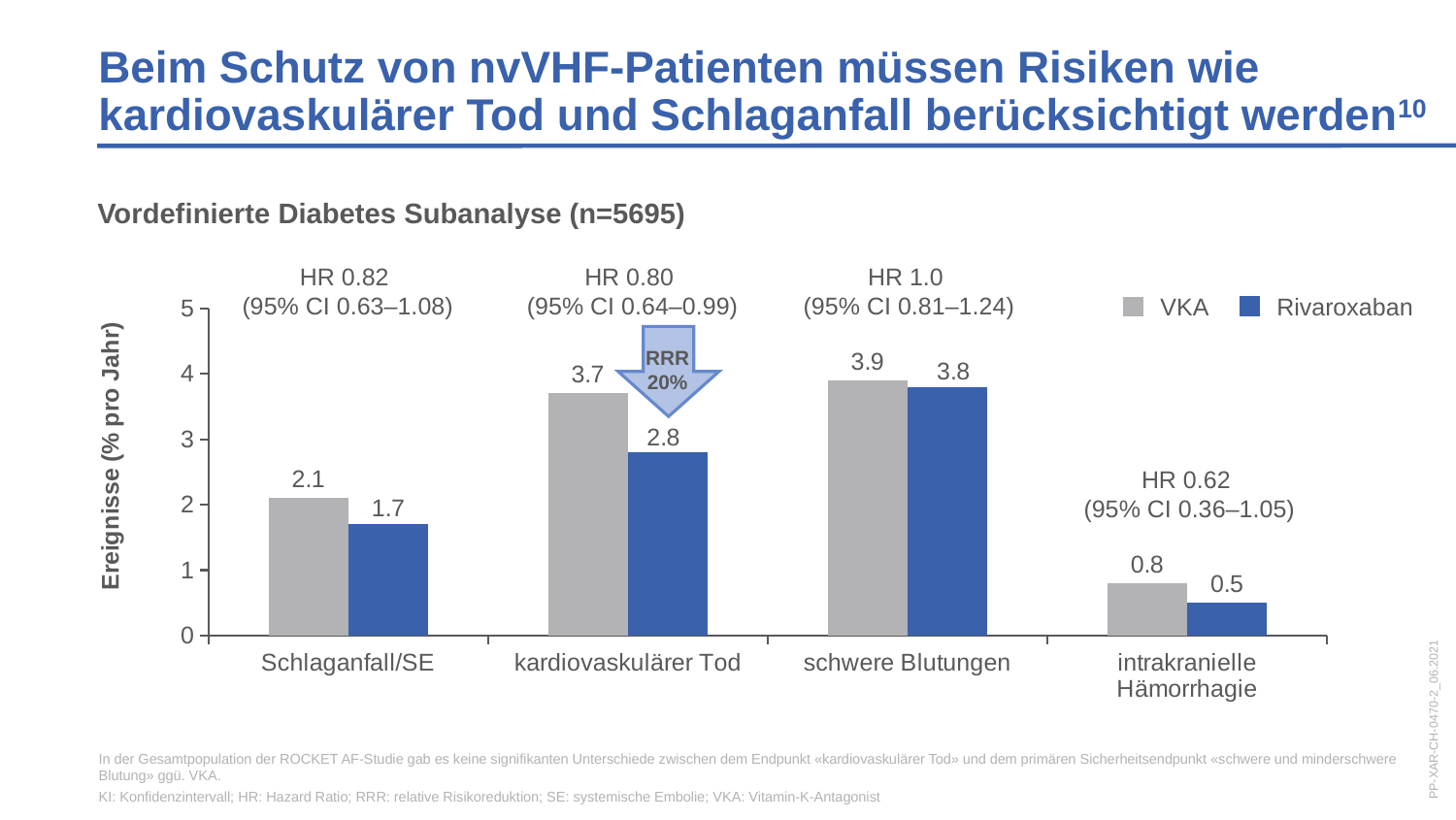
Which is larger for schwere Blutungen, the VKA value or the Rivaroxaban value? VKA How many series does the legend list? 2 What kind of chart is shown on the slide? bar chart What is the Rivaroxaban value for Schlaganfall/SE? 1.7 How many categories are shown on the x axis? 4 What is the Rivaroxaban value for intrakranielle Hämorrhagie? 0.5 Which category has the highest VKA value? schwere Blutungen What is the label of the y axis? Ereignisse (% pro Jahr) What is the difference between the VKA and Rivaroxaban values for kardiovaskulärer Tod? 0.9 What is the VKA value for kardiovaskulärer Tod? 3.7 Which category has the lowest Rivaroxaban value? intrakranielle Hämorrhagie What is the hazard ratio shown above the kardiovaskulärer Tod bars? HR 0.80